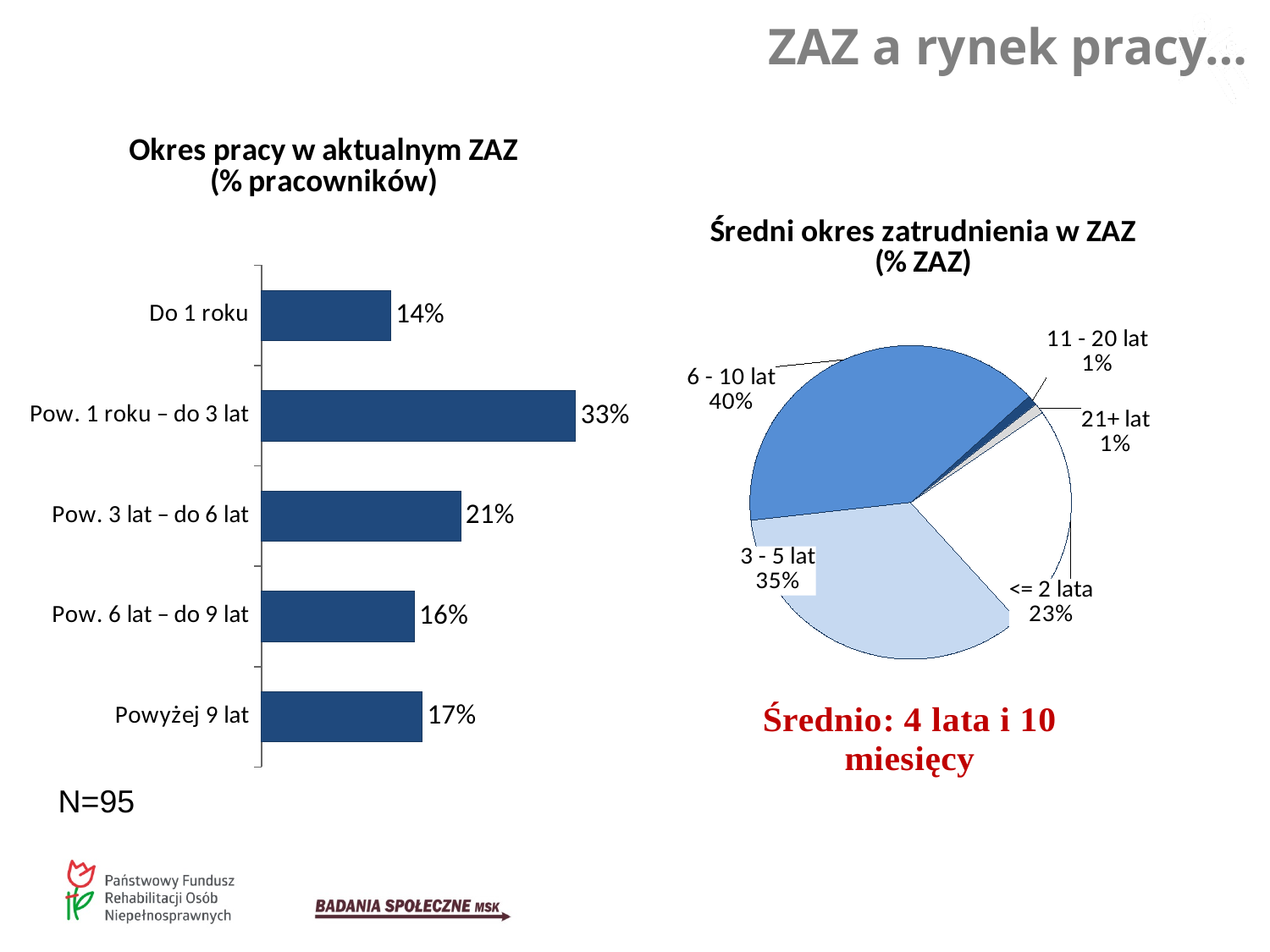
In the chart 'Okres pracy w aktualnym ZAZ (% pracowników)', what is the value for 'Do 1 roku'? 14% In the chart 'Średni okres zatrudnienia w ZAZ (% ZAZ)', which slice is the largest? 6 - 10 lat How many categories are shown in the chart 'Okres pracy w aktualnym ZAZ (% pracowników)'? 5 In the chart 'Okres pracy w aktualnym ZAZ (% pracowników)', which category has the highest value? Pow. 1 roku – do 3 lat In the chart 'Okres pracy w aktualnym ZAZ (% pracowników)', what is the difference between 'Pow. 1 roku – do 3 lat' and 'Pow. 3 lat – do 6 lat'? 12% In the chart 'Okres pracy w aktualnym ZAZ (% pracowników)', which is larger: 'Pow. 6 lat – do 9 lat' or 'Powyżej 9 lat'? Powyżej 9 lat In the chart 'Średni okres zatrudnienia w ZAZ (% ZAZ)', what is the value for '<= 2 lata'? 23% What kind of chart is 'Średni okres zatrudnienia w ZAZ (% ZAZ)'? Pie chart In the chart 'Średni okres zatrudnienia w ZAZ (% ZAZ)', what share does the '6 - 10 lat' slice have? 40% In the chart 'Okres pracy w aktualnym ZAZ (% pracowników)', which category has the lowest value? Do 1 roku What kind of chart is 'Okres pracy w aktualnym ZAZ (% pracowników)'? Bar chart In the chart 'Okres pracy w aktualnym ZAZ (% pracowników)', what is the value for 'Pow. 1 roku – do 3 lat'? 33%